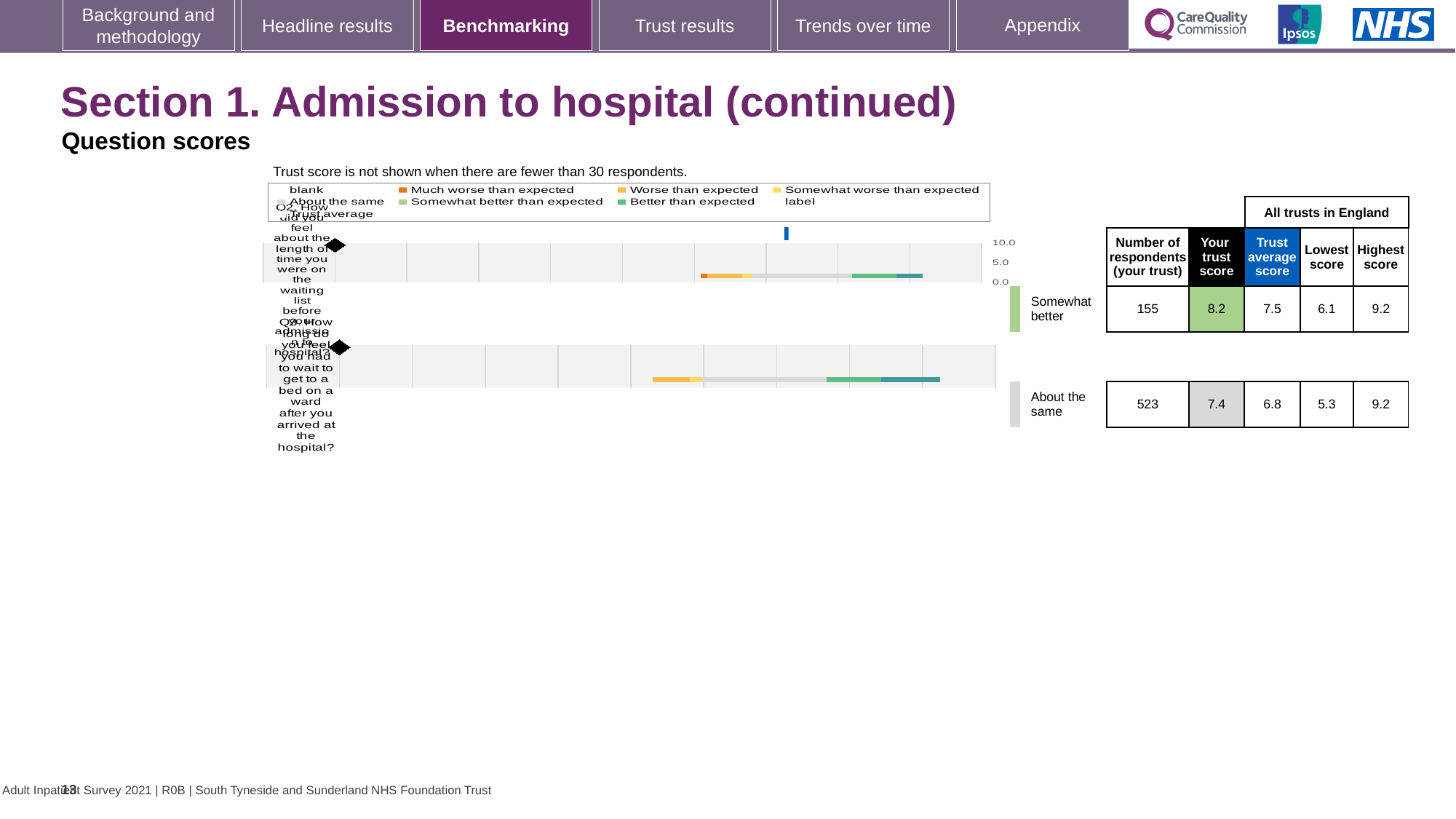
According to the note above the chart, when is the trust score not shown? When there are fewer than 30 respondents What is the trust average score for all trusts in England for Q2? 7.5 How many questions (categories) are plotted in the question scores chart? 2 What is the difference between the highest and lowest scores across all trusts in England for Q3? 3.9 Which question has the higher trust score, Q2 or Q3? Q2 What benchmark category is shown for Q3's trust score? About the same Which question has more respondents, Q2 or Q3? Q3 How many respondents answered Q3 (how long did you feel you had to wait to get to a bed on a ward)? 523 What is the lowest score across all trusts in England for Q3? 5.3 What kind of chart is used to show the question scores on this slide? bar chart By how much does the trust score for Q2 exceed the trust average score for Q2? 0.7 What is the trust score for Q2 (how did you feel about the length of time you were on the waiting list before admission)? 8.2